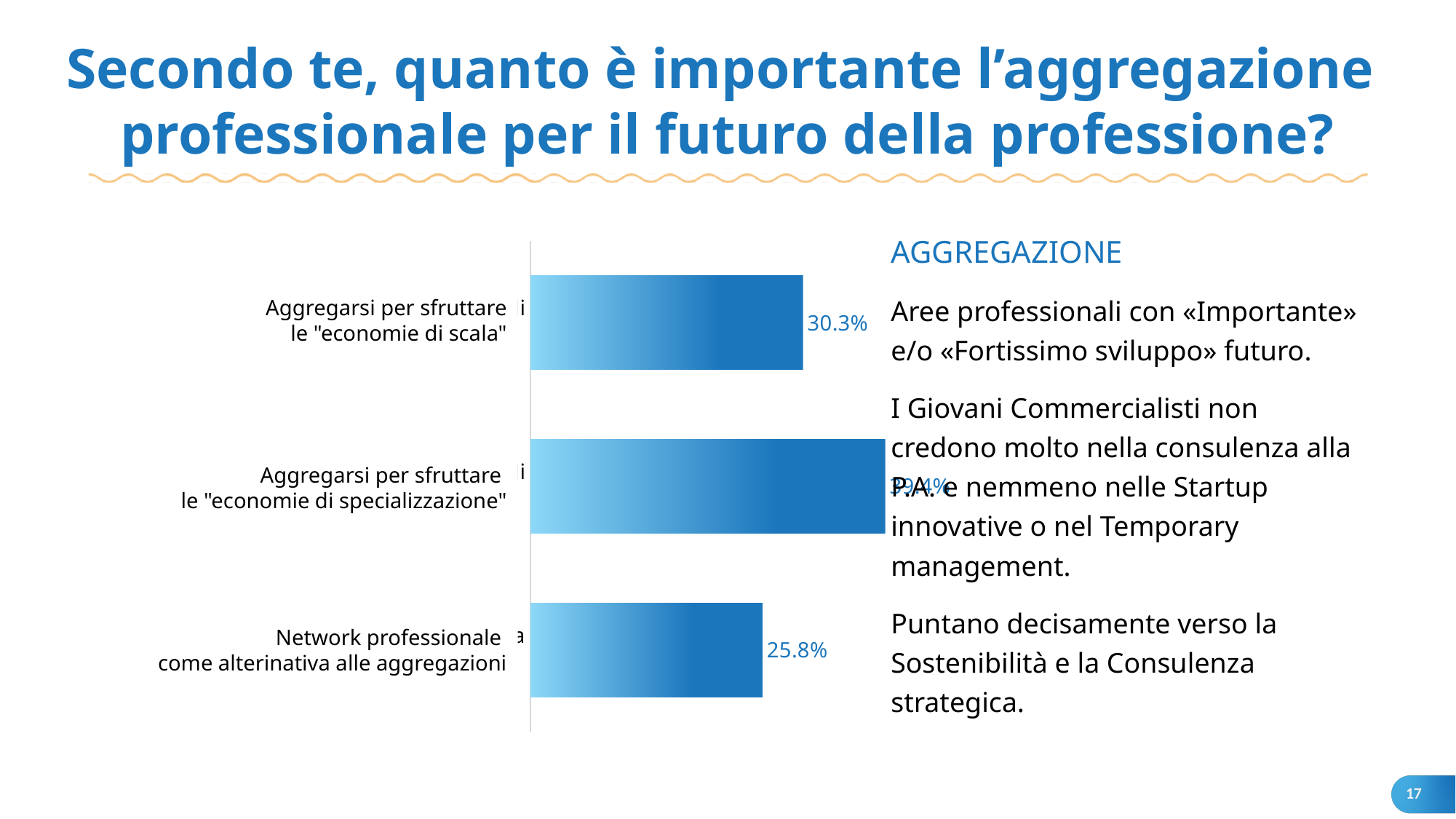
How many categories are shown in the chart? 3 Which is larger: the value for "economie di scala" or the value for "Network professionale come alternativa alle aggregazioni"? Aggregarsi per sfruttare le "economie di scala" What is the value for "Network professionale come alternativa alle aggregazioni"? 25.8% What is the heading of the text block to the right of the chart? AGGREGAZIONE What is the difference between the value for "economie di scala" and the value for "Network professionale come alternativa alle aggregazioni"? 4.5 percentage points What kind of chart is shown on the slide? Bar chart Which is larger: the bar for "economie di specializzazione" or the bar for "economie di scala"? Aggregarsi per sfruttare le "economie di specializzazione" Which category has the lowest value? Network professionale come alternativa alle aggregazioni What is the value for "Aggregarsi per sfruttare le 'economie di scala'"? 30.3% Which category has the longest bar? Aggregarsi per sfruttare le "economie di specializzazione" Are the bars in the chart oriented horizontally or vertically? Horizontally